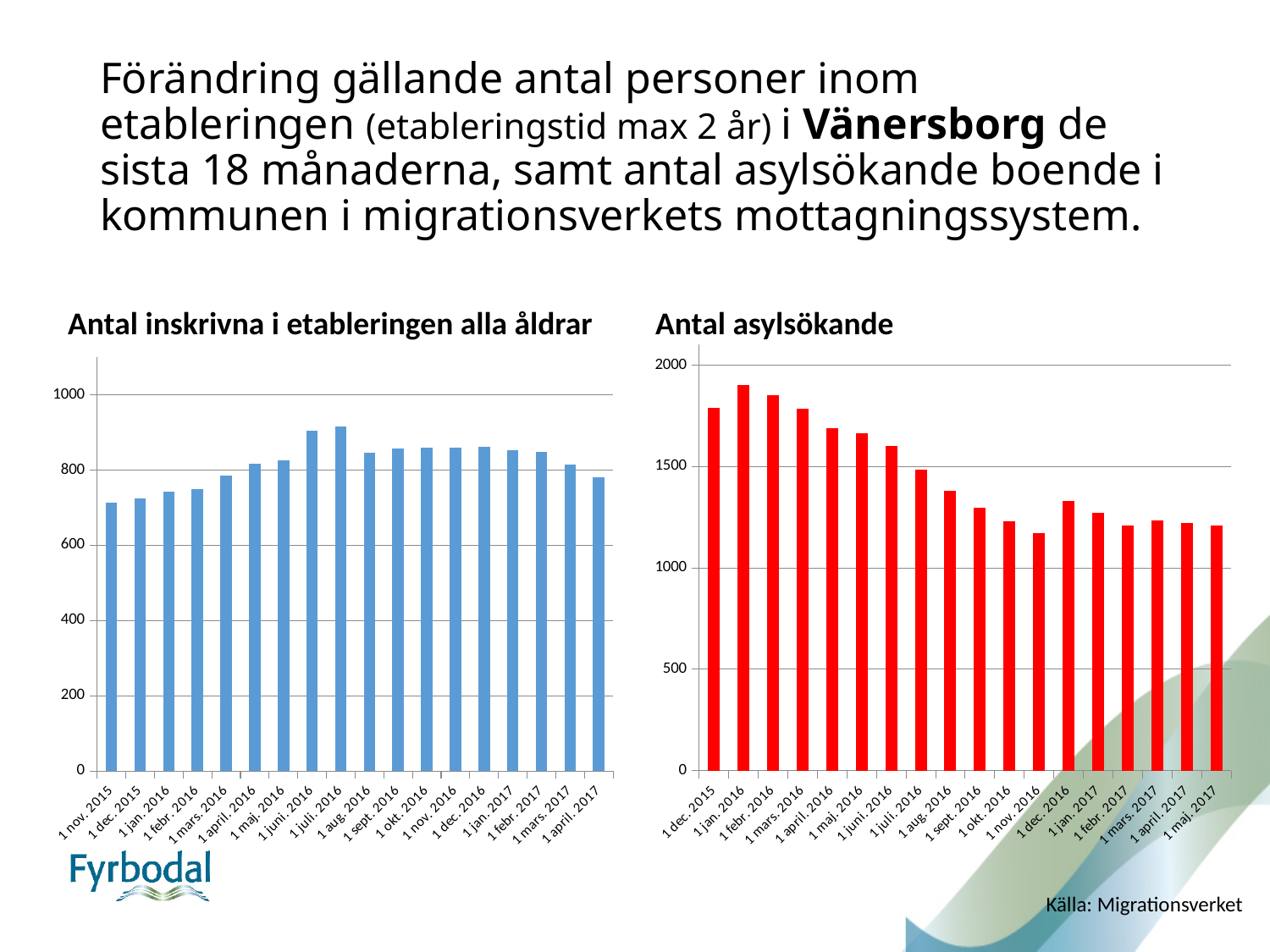
In the 'Antal asylsökande' chart, is the value for 1 aug. 2016 greater or less than 1500? less In the 'Antal inskrivna i etableringen alla åldrar' chart, is the value for 1 juni 2016 greater or less than 800? greater In the 'Antal asylsökande' chart, which is larger: the value for 1 jan. 2016 or the value for 1 maj 2017? 1 jan. 2016 How many bars are shown in the 'Antal asylsökande' chart? 18 What colour are the bars in the 'Antal asylsökande' chart? red In the 'Antal asylsökande' chart, which month has the highest value? 1 jan. 2016 In the 'Antal asylsökande' chart, which month has the lowest value? 1 nov. 2016 In the 'Antal asylsökande' chart, is the value for 1 jan. 2016 greater or less than 1500? greater In the 'Antal asylsökande' chart, do the values generally rise or fall from 1 dec. 2015 to 1 maj 2017? fall What kind of chart is the 'Antal asylsökande' chart? bar chart How many months (bars) are shown in the 'Antal inskrivna i etableringen alla åldrar' chart? 18